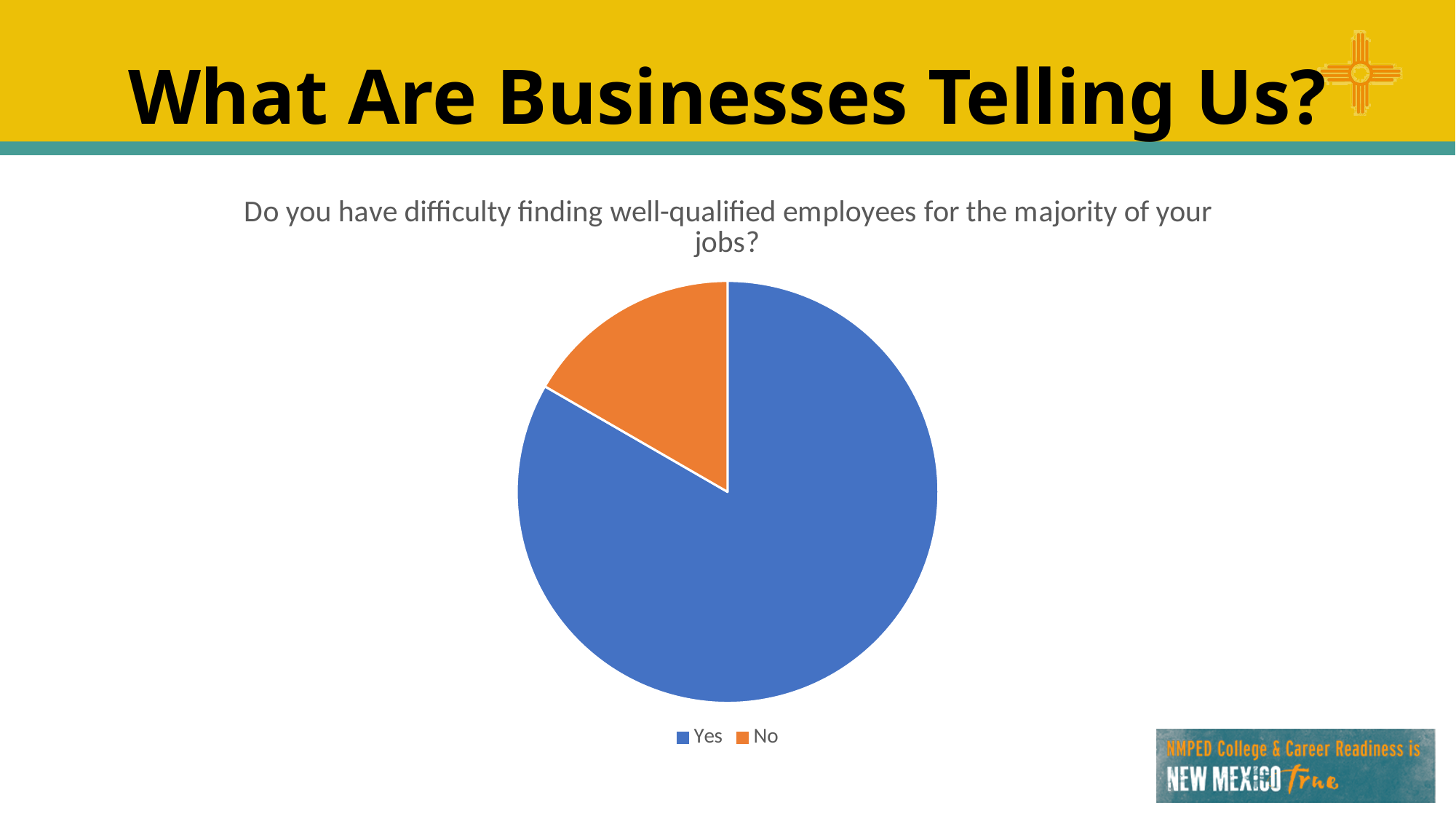
Does the Yes slice take up more or less than half of the pie chart? more What colour is the No slice in the pie chart? orange What is the title of the pie chart? Do you have difficulty finding well-qualified employees for the majority of your jobs? How many entries does the legend of the pie chart list? 2 Which response has the largest slice of the pie chart? Yes What kind of chart is shown on the slide? pie chart Which slice is larger in the pie chart, Yes or No? Yes How many slices does the pie chart have? 2 Which response has the smallest slice of the pie chart? No